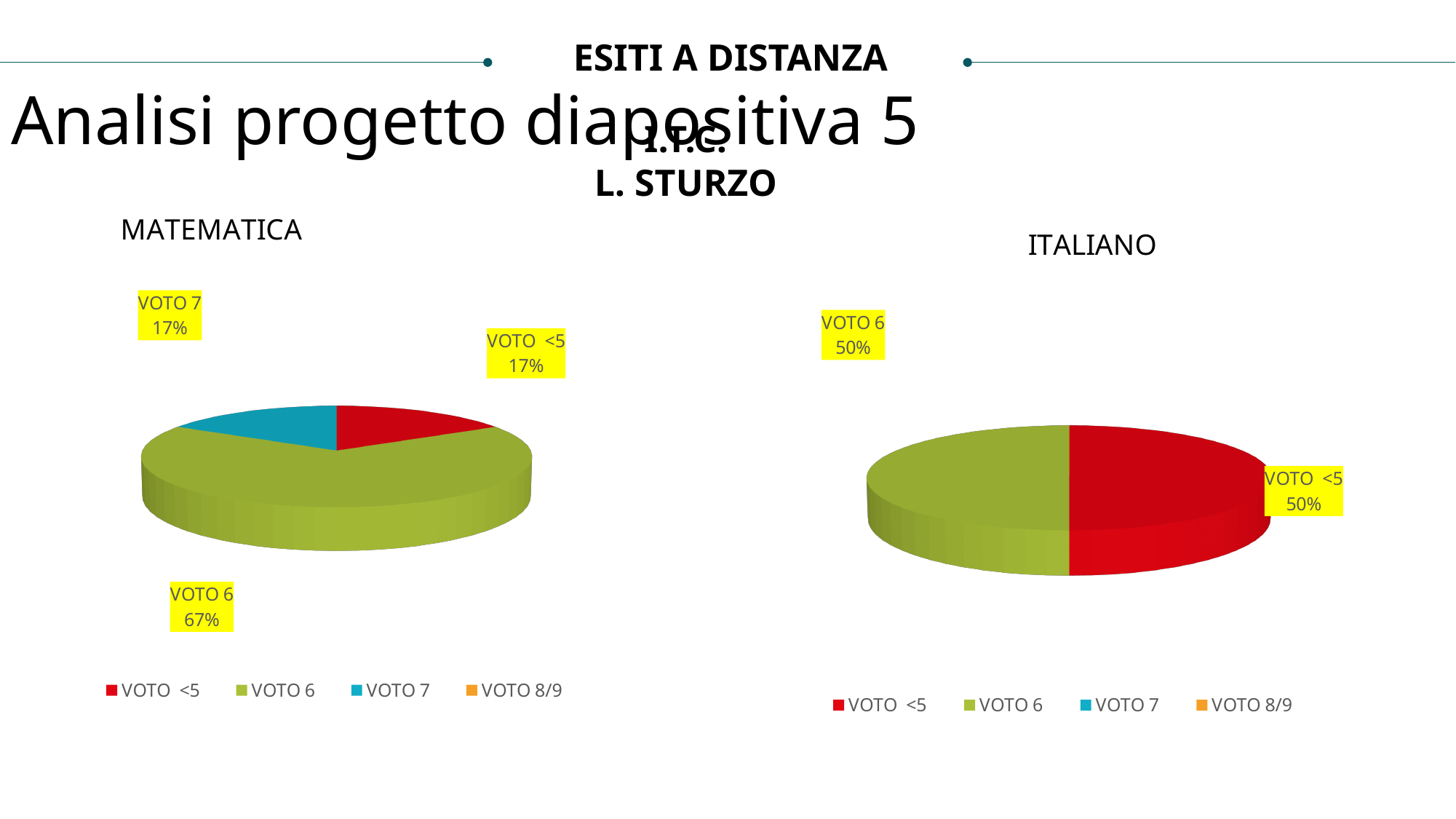
In the ITALIANO chart, what share does VOTO 6 have? 50% What kind of chart is the MATEMATICA chart? Pie chart In the MATEMATICA chart, which category has the largest slice? VOTO 6 In the MATEMATICA chart, what share does VOTO <5 have? 17% In the MATEMATICA chart, what share does VOTO 6 have? 67% In the ITALIANO chart, how many slices are visible in the pie? 2 In the ITALIANO chart, what share does VOTO <5 have? 50% In the MATEMATICA chart, what is the difference between the VOTO 6 share and the VOTO 7 share? 50% In the MATEMATICA chart, how many slices are visible in the pie? 3 How many entries does the legend of the ITALIANO chart list? 4 In the MATEMATICA chart, which colour represents VOTO 7? Blue In the MATEMATICA chart, what share does VOTO 7 have? 17%